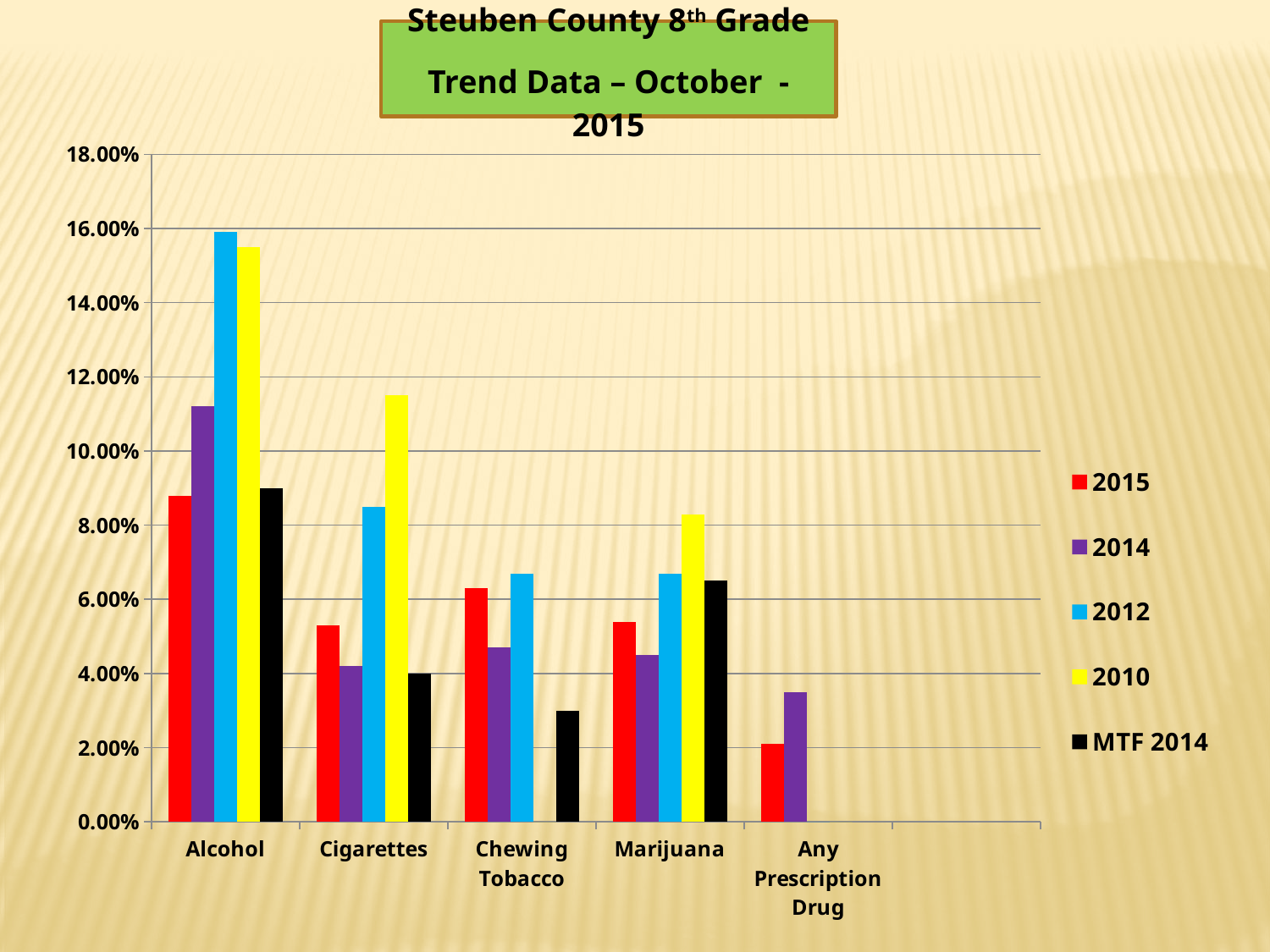
For Cigarettes, which series has the larger value, 2010 or 2012? 2010 For Any Prescription Drug, which series has the larger value, 2014 or 2015? 2014 How many substance categories are shown on the x axis? 5 Which category has the highest value for the 2012 series? Alcohol What kind of chart is shown on the slide? Bar chart Is the 2012 value for Alcohol greater or less than 14.00%? greater Is the 2014 value for Alcohol greater or less than 10.00%? greater Is the 2010 value for Cigarettes greater or less than 10.00%? greater How many series does the legend list? 5 Which category has the lowest value for the 2015 series? Any Prescription Drug What colour represents the 2010 series in the legend? Yellow